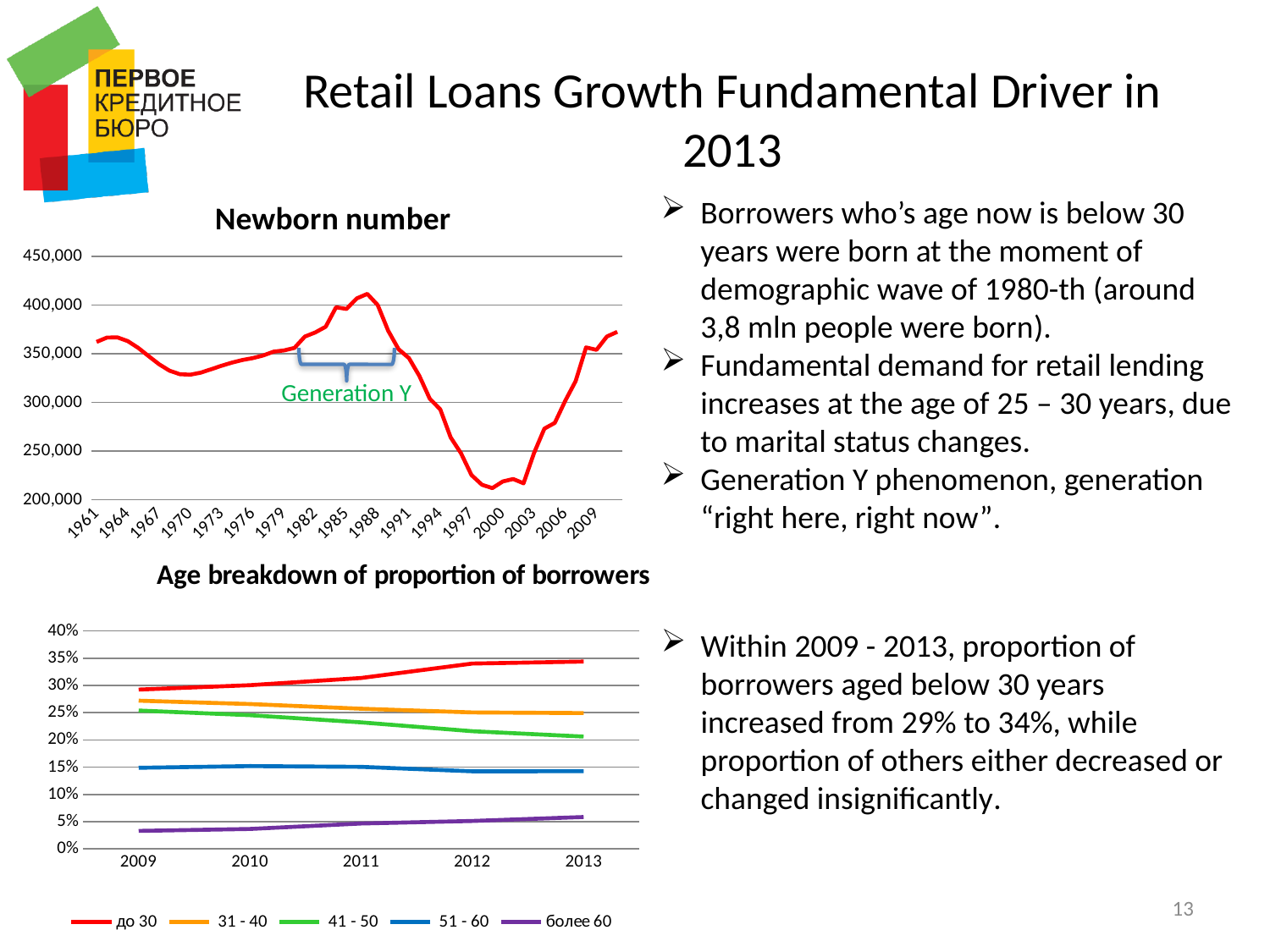
In the 'Age breakdown of proportion of borrowers' chart, which series has the highest value in 2013? до 30 In the 'Newborn number' chart, is the value for 1969 greater or less than 350,000? less How many series does the legend of the 'Age breakdown of proportion of borrowers' chart list? 5 What type of chart is the 'Newborn number' chart? line chart In the 'Age breakdown of proportion of borrowers' chart, is the value for 'до 30' in 2013 greater or less than 30%? greater In the 'Newborn number' chart, is the value for 1999 greater or less than 250,000? less In the 'Newborn number' chart, do the values rise or fall between 1988 and 1999? fall How many years are shown on the x axis of the 'Age breakdown of proportion of borrowers' chart? 5 In the 'Age breakdown of proportion of borrowers' chart, which is larger in 2009: '31 - 40' or '41 - 50'? 31 - 40 In the 'Age breakdown of proportion of borrowers' chart, does the '41 - 50' series rise or fall from 2009 to 2013? fall In the 'Age breakdown of proportion of borrowers' chart, which series has the lowest value in 2013? более 60 In the 'Newborn number' chart, what label is written under the bracket marking the early-to-late 1980s? Generation Y